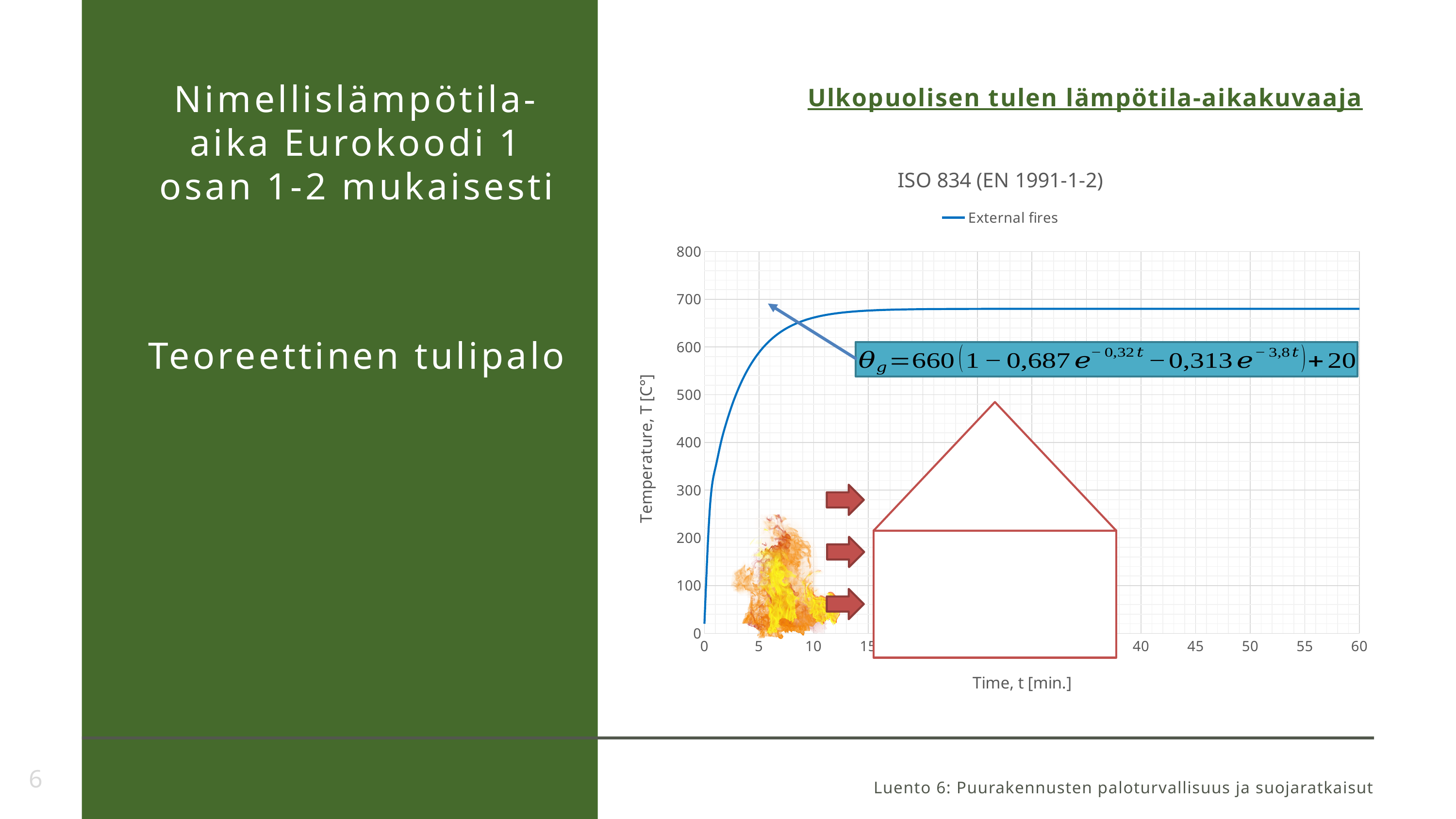
What is the highest value shown on the vertical axis of the chart? 800 Is the External fires temperature at 30 minutes greater or less than 500? greater How many series does the chart legend list? 1 What is the name of the series shown in the chart legend? External fires Is the External fires temperature at 60 minutes greater or less than 700? less What is the highest value shown on the horizontal axis of the chart? 60 Does the External fires temperature rise or fall as time increases from 0 to 10 minutes? rise What kind of chart is shown on the slide? line chart Is the External fires temperature at 60 minutes greater or less than 600? greater